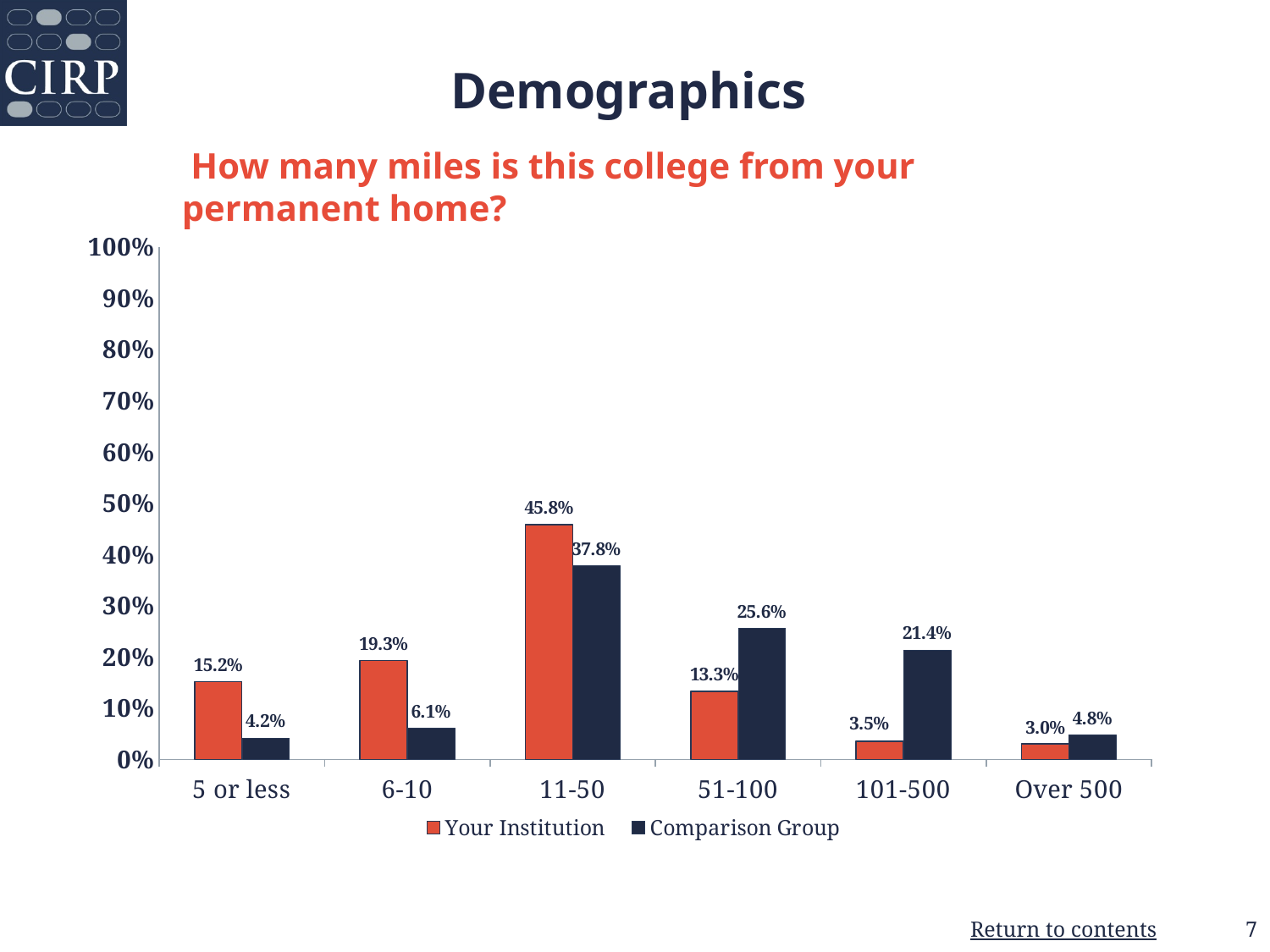
What is the value for Your Institution in the Over 500 category? 3.0% What question does the chart's subtitle ask? How many miles is this college from your permanent home? How many categories are shown on the x axis? 6 Which is larger in the 101-500 category, Your Institution or Comparison Group? Comparison Group What is the difference between Your Institution and Comparison Group in the 6-10 category? 13.2% How many series does the legend list? 2 Is the value for Your Institution in the 11-50 category greater or less than 40%? greater What is the value for Comparison Group in the 51-100 category? 25.6% What is the value for Your Institution in the 11-50 category? 45.8% Which category has the highest value for Comparison Group? 11-50 What kind of chart is shown on the slide? bar chart Which category has the lowest value for Your Institution? Over 500